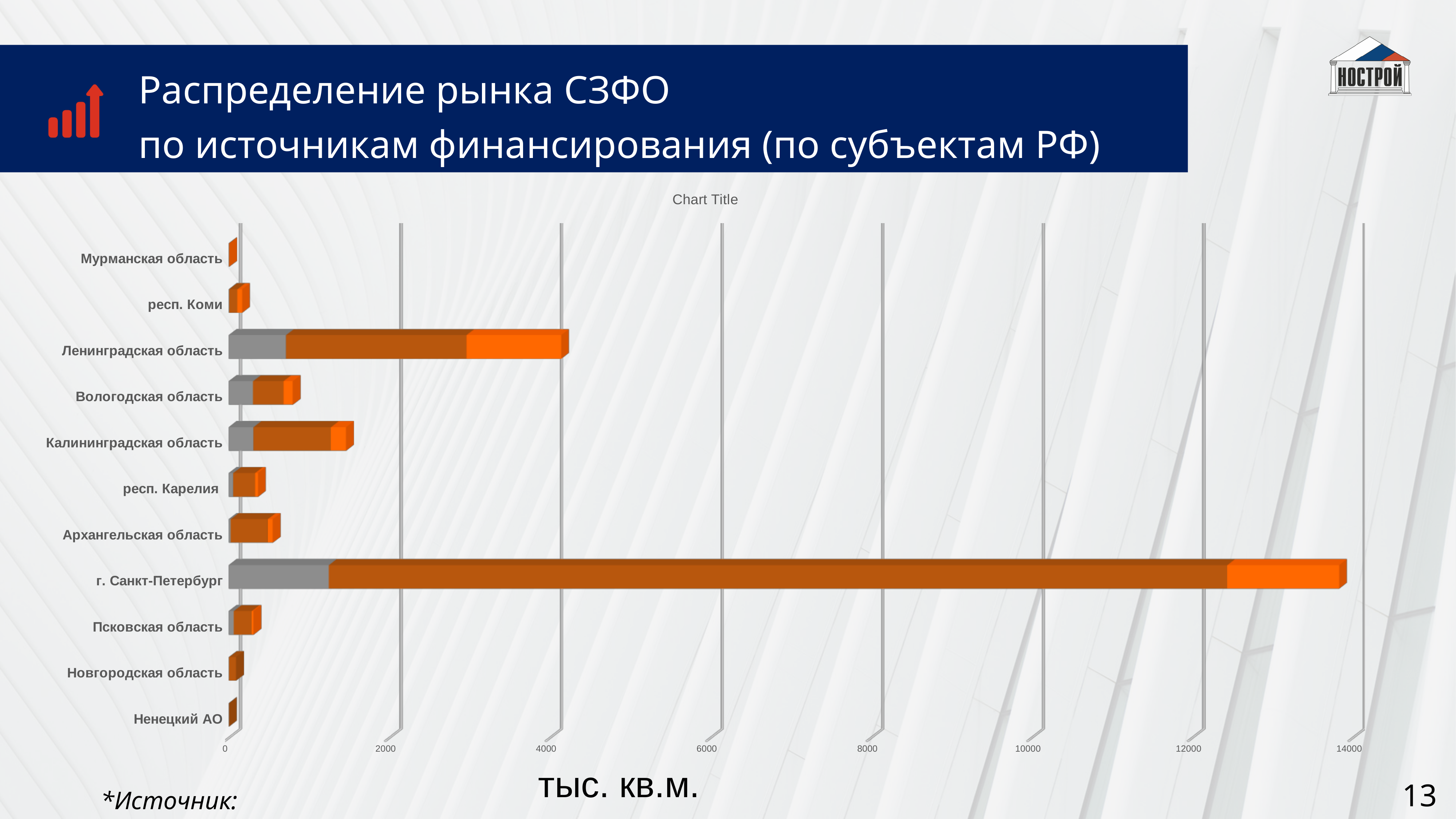
Which region has the longest bar on the chart? г. Санкт-Петербург What is the title printed above the chart? Chart Title Is the total value for Калининградская область greater or less than 2000? less What kind of chart is shown on the slide? bar chart Is the total value for г. Санкт-Петербург greater or less than 12000? greater Which has the larger total value, Калининградская область or респ. Карелия? Калининградская область How many regions (categories) are plotted on the chart? 11 What unit is printed below the chart's horizontal axis? тыс. кв.м. Which has the larger total value, Ленинградская область or Калининградская область? Ленинградская область Is the total value for Ленинградская область greater or less than 2000? greater Which has the larger total value, г. Санкт-Петербург or Ленинградская область? г. Санкт-Петербург